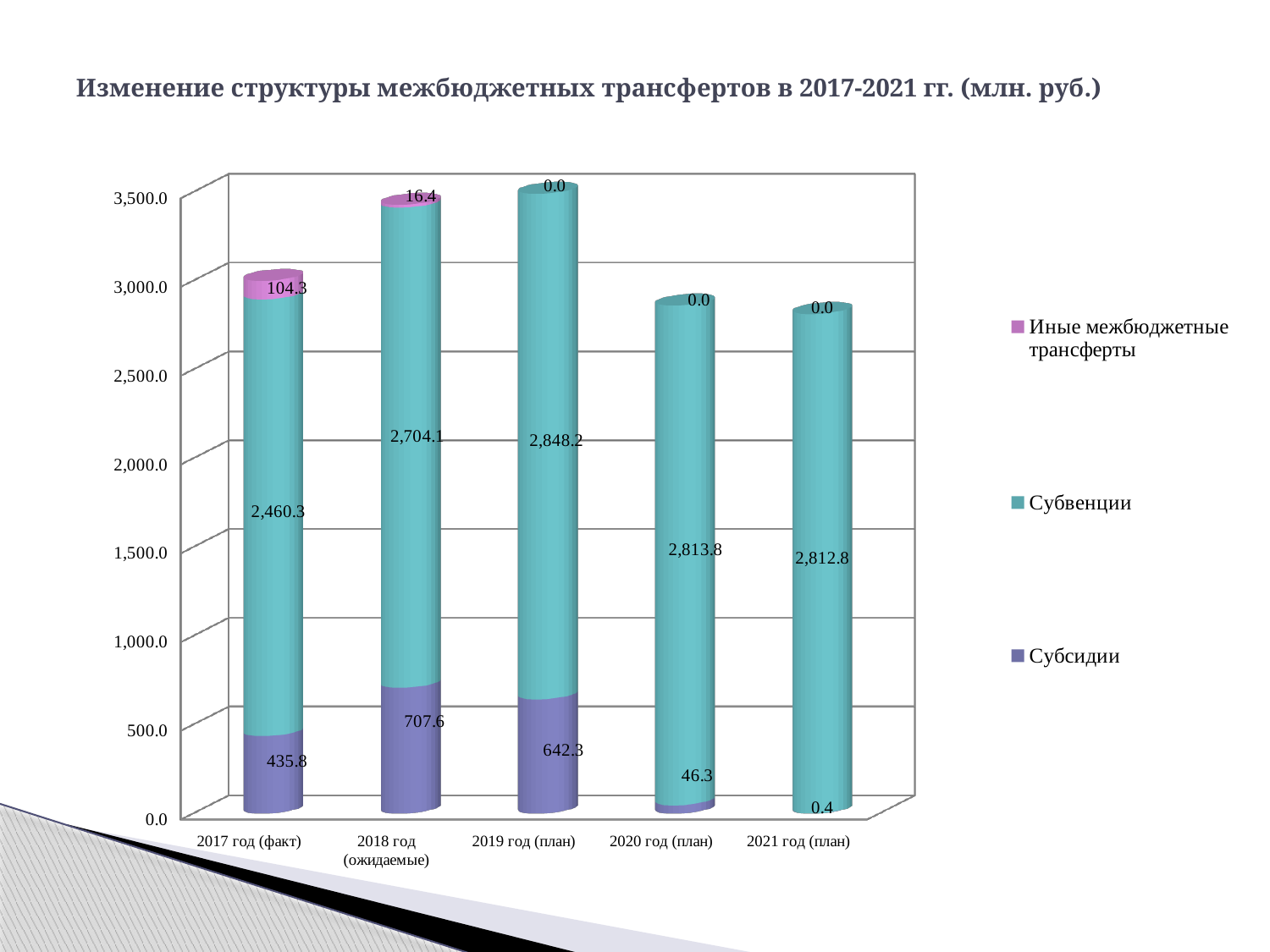
What is the value of Иные межбюджетные трансферты for 2017 год (факт)? 104.3 Which year has the highest value for Субсидии? 2018 год (ожидаемые) Which year has the lowest value for Субвенции? 2017 год (факт) How many series does the legend list? 3 What is the value of Субсидии for 2018 год (ожидаемые)? 707.6 What is the value of Субвенции for 2019 год (план)? 2,848.2 How many categories are shown on the x axis? 5 What kind of chart is shown on the slide? Stacked bar chart Which is larger: Субсидии for 2019 год (план) or Субсидии for 2020 год (план)? 2019 год (план) What is the value of Субсидии for 2021 год (план)? 0.4 What is the total of the stacked bar for 2017 год (факт)? 3,000.4 What is the difference between the Субвенции values for 2019 год (план) and 2018 год (ожидаемые)? 144.1